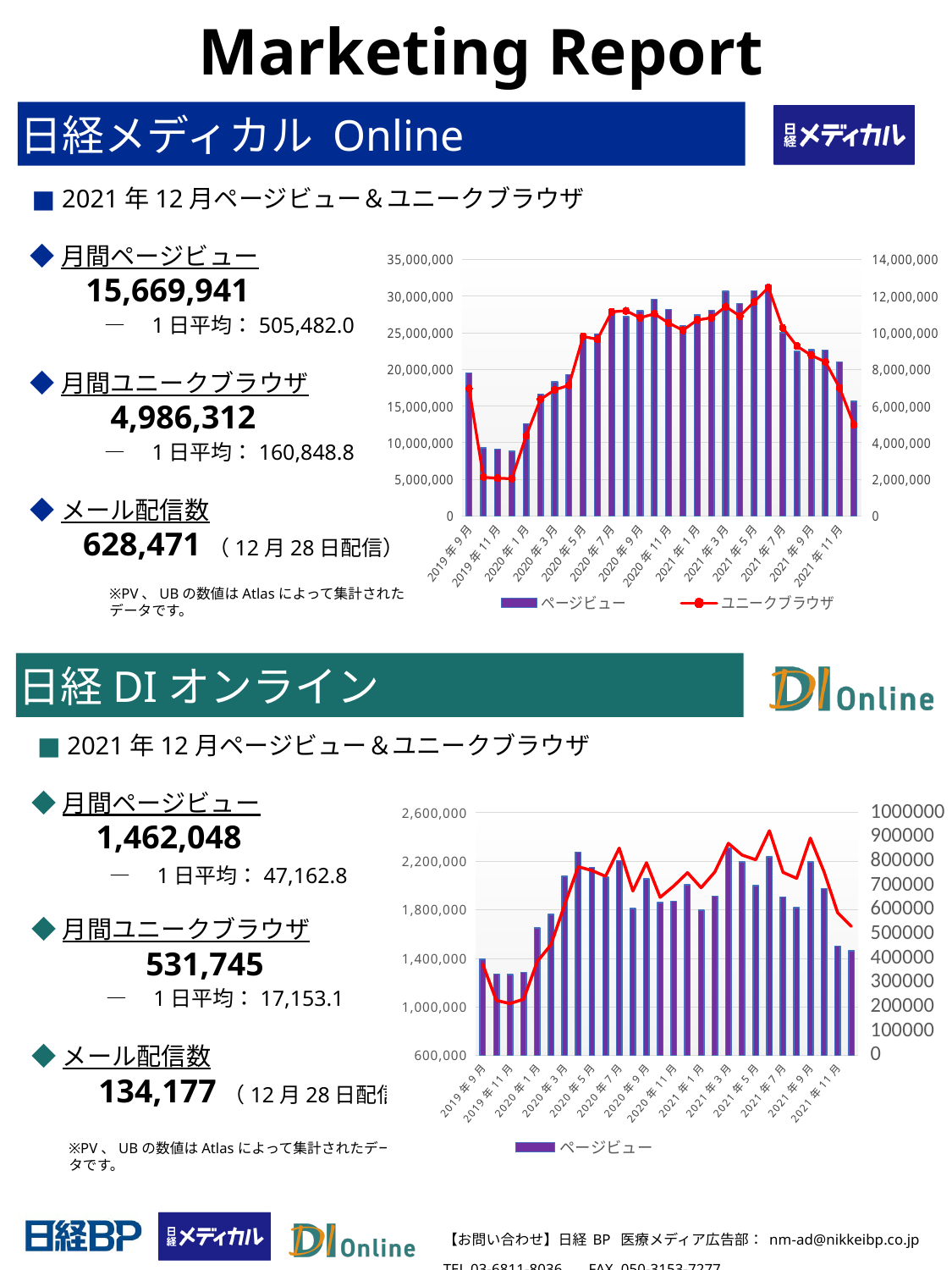
What kind of chart is the 日経メディカル Online chart? Combination bar and line chart On the 日経 DI オンライン chart, is the ページビュー bar for 2019年11月 greater or less than 1,400,000? less On the 日経メディカル Online chart, is the ページビュー bar for 2019年9月 greater or less than 15,000,000? greater On the 日経 DI オンライン chart, how many series does the legend list? 1 On the 日経メディカル Online chart, how many series does the legend list? 2 On the 日経メディカル Online chart, what colour is the ユニークブラウザ line? Red On the 日経メディカル Online chart, do the ページビュー bars rise or fall from 2019年11月 to 2020年7月? rise On the 日経メディカル Online chart, which has the taller ページビュー bar, 2019年9月 or 2019年11月? 2019年9月 On the 日経 DI オンライン chart, do the ページビュー bars rise or fall from 2021年9月 to 2021年11月? fall On the 日経 DI オンライン chart, is the ページビュー bar for 2020年5月 greater or less than 1,800,000? greater